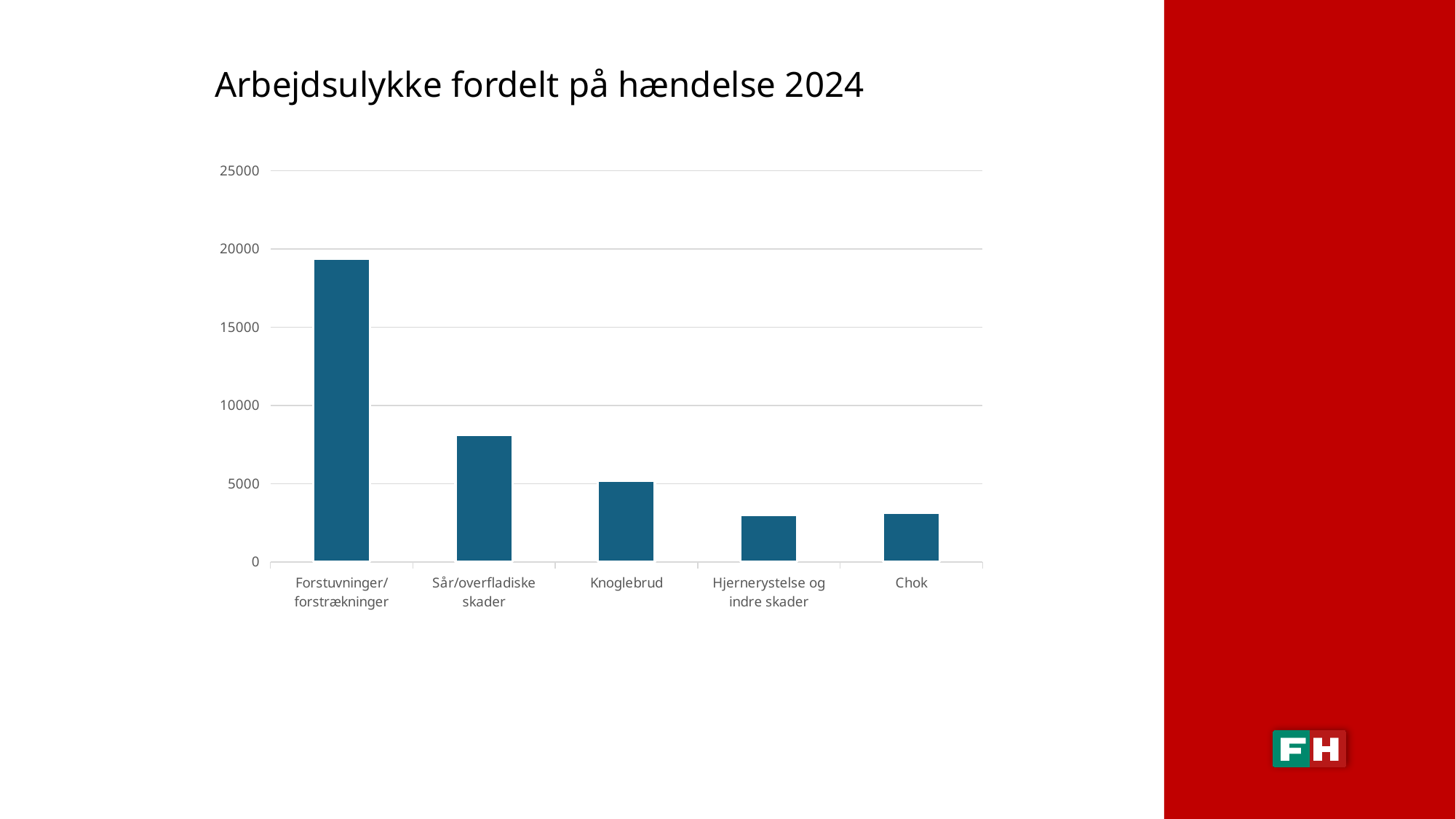
Which is larger, the value for Knoglebrud or the value for Chok? Knoglebrud How many categories are shown on the x axis of the chart? 5 What kind of chart is shown on the slide? bar chart Which is larger, the value for Sår/overfladiske skader or the value for Knoglebrud? Sår/overfladiske skader Is the value for Forstuvninger/forstrækninger greater or less than 15000? greater Is the value for Sår/overfladiske skader greater or less than 5000? greater Is the value for Hjernerystelse og indre skader greater or less than 5000? less Which category has the highest value in the chart? Forstuvninger/forstrækninger What is the title of the chart? Arbejdsulykke fordelt på hændelse 2024